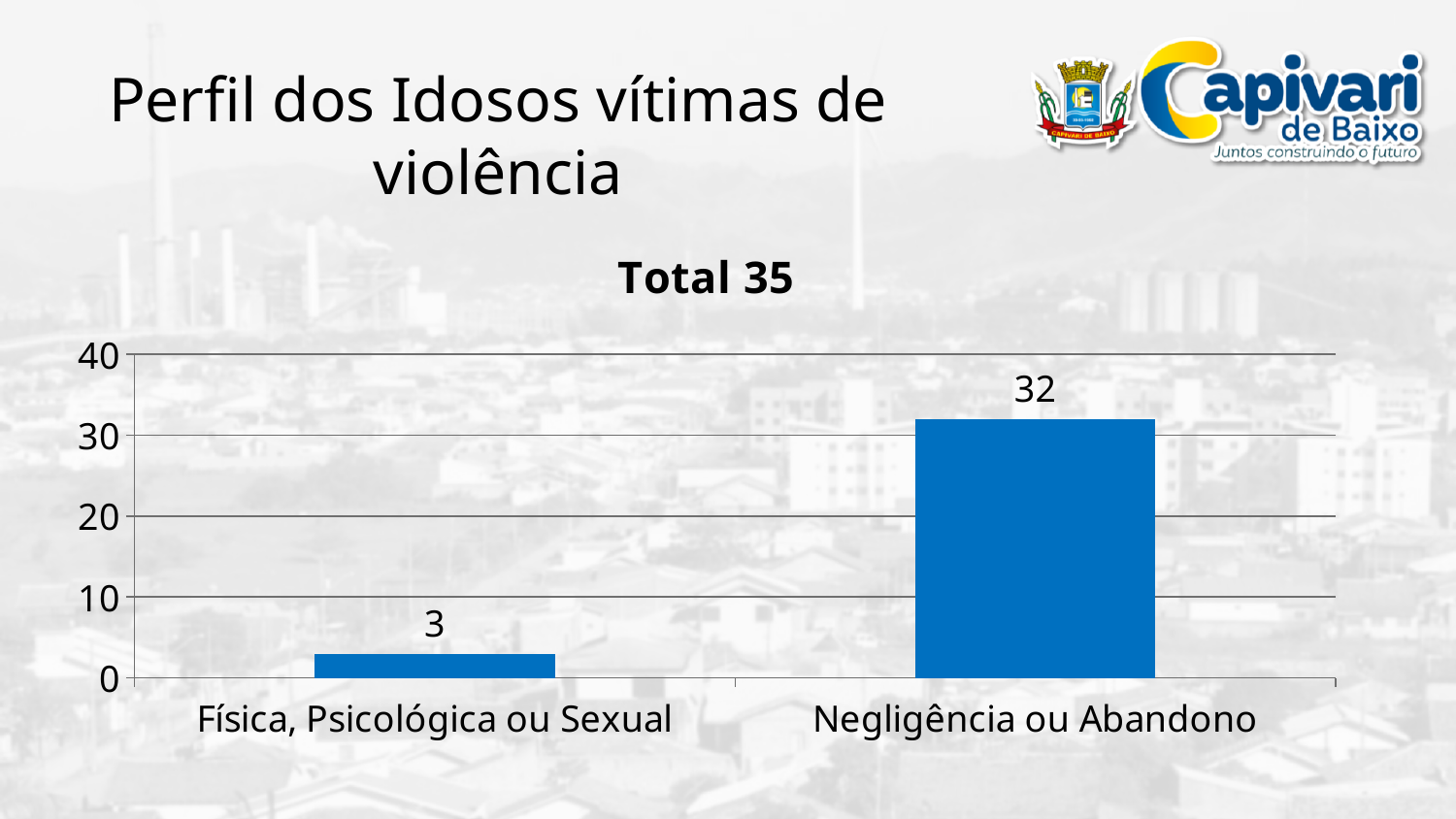
How many categories are shown in the chart? 2 Which category has the highest value? Negligência ou Abandono What kind of chart is shown on the slide? Bar chart Which is larger, the value for Física, Psicológica ou Sexual or the value for Negligência ou Abandono? Negligência ou Abandono What is the value for Negligência ou Abandono? 32 What is the value for Física, Psicológica ou Sexual? 3 What is the difference between the values for Negligência ou Abandono and Física, Psicológica ou Sexual? 29 Which category has the lowest value? Física, Psicológica ou Sexual What is the highest value shown on the vertical axis? 40 Is the value for Física, Psicológica ou Sexual greater or less than 10? less Is the value for Negligência ou Abandono greater or less than 20? greater What is the title of the chart? Total 35